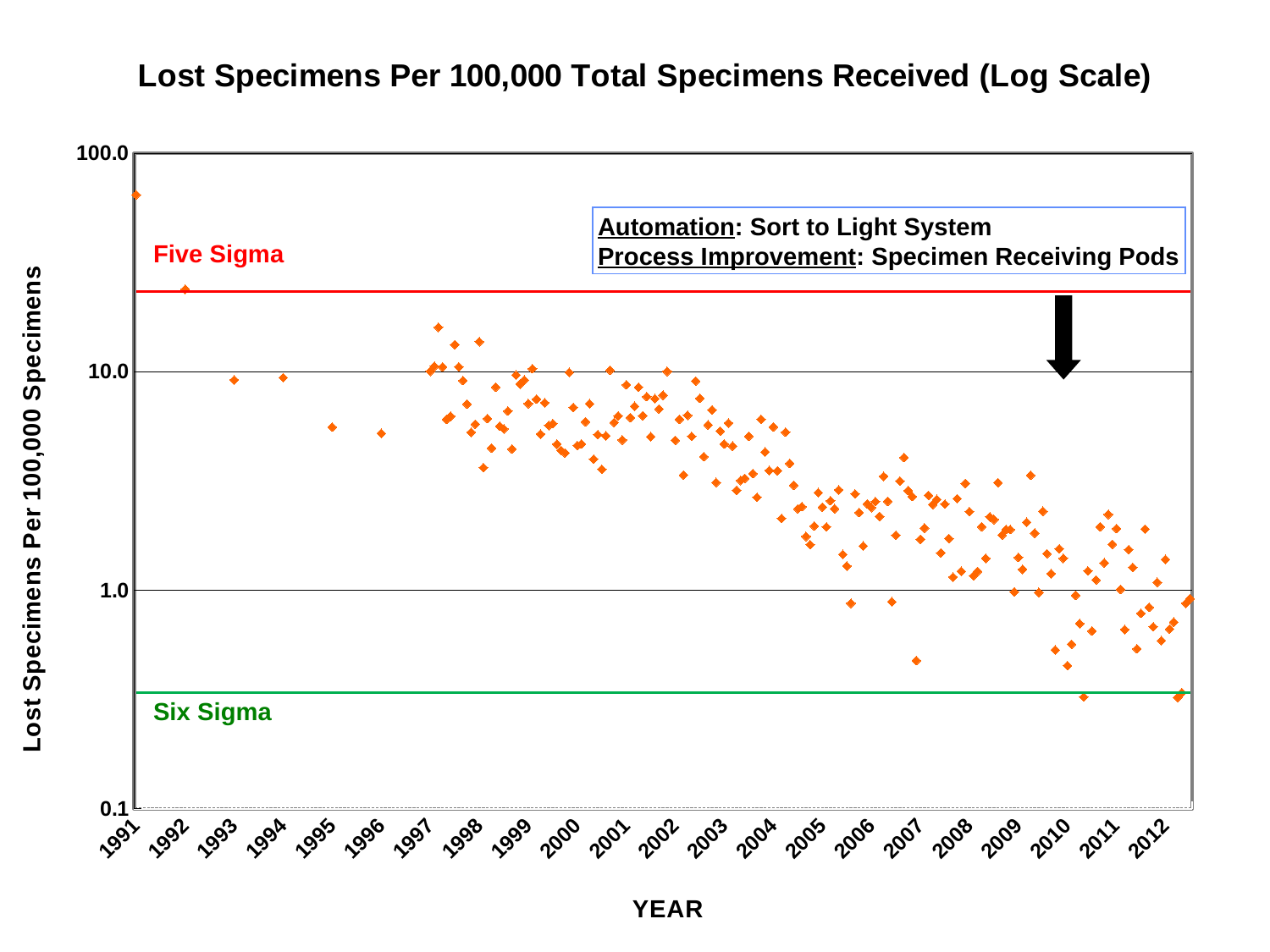
What is the title of the chart? Lost Specimens Per 100,000 Total Specimens Received (Log Scale) What label is shown on the x axis? YEAR Which reference line is higher on the chart, Five Sigma or Six Sigma? Five Sigma Do the plotted values generally rise or fall from 1991 to 2012? fall What kind of chart is shown on the slide? scatter chart Is the first plotted point in 1991 greater or less than 10.0? greater Is the Five Sigma reference line greater or less than 10.0? greater Are the plotted points in 2012 mostly greater or less than 10.0? less How many year labels are shown along the x axis? 22